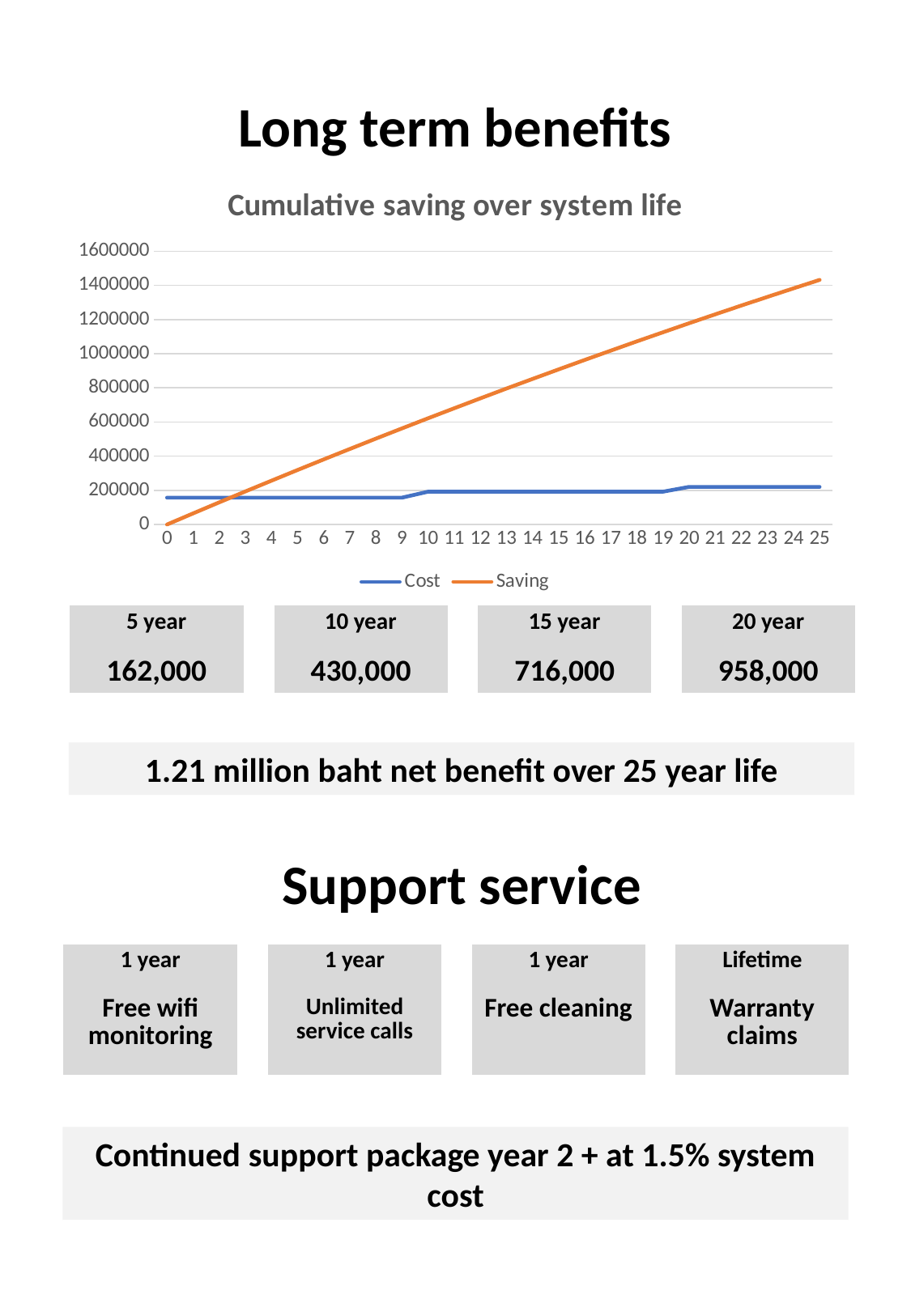
What colour is the Saving line in the chart? orange What is the value of the Saving series at year 0? 0 Is the value for Cost at year 5 greater or less than 400000? less What kind of chart is shown under 'Cumulative saving over system life'? line chart Does the Saving line rise or fall as the years increase along the x axis? rise Is the value for Saving at year 15 greater or less than 800000? greater Is the value for Saving at year 5 greater or less than 200000? greater At year 25, which series has the larger value, Cost or Saving? Saving What are the two series named in the legend of the chart? Cost and Saving How many series does the legend of the 'Cumulative saving over system life' chart list? 2 How many year points are shown on the x axis of the chart (from 0 to 25)? 26